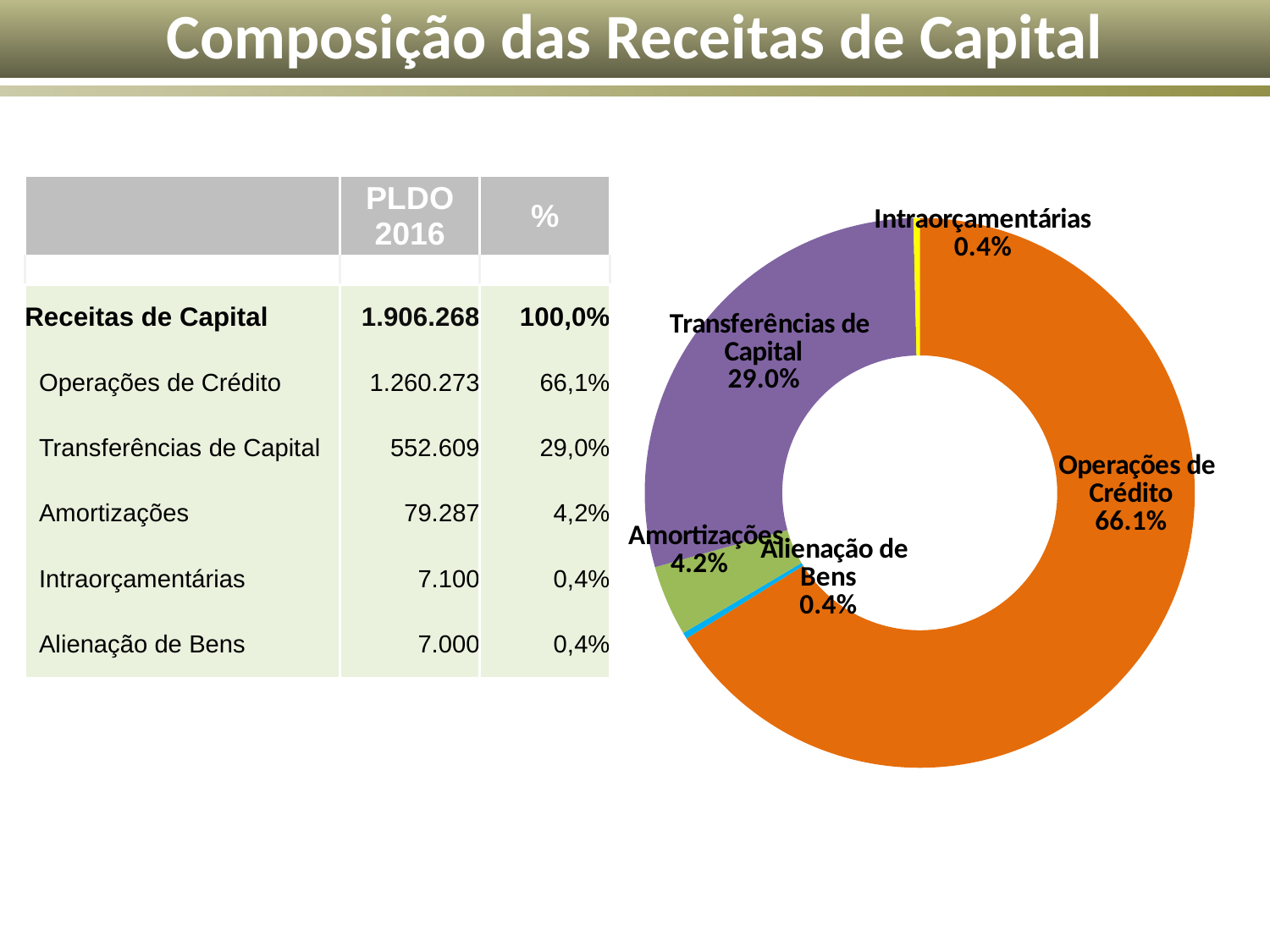
What colour is the Operações de Crédito slice in the donut chart? Orange What percentage is shown for Intraorçamentárias in the donut chart? 0.4% What is the difference in percentage points between Amortizações and Alienação de Bens in the donut chart? 3.8 How many slices does the donut chart have? 5 What share of the donut chart does Operações de Crédito represent? 66.1% What percentage is shown for Amortizações in the donut chart? 4.2% Which category has the largest slice in the donut chart? Operações de Crédito What share of the donut chart does Transferências de Capital represent? 29.0% What is the difference in percentage points between Operações de Crédito and Transferências de Capital in the donut chart? 37.1 In the donut chart, which is larger: Transferências de Capital or Amortizações? Transferências de Capital What colour is the Transferências de Capital slice in the donut chart? Purple What kind of chart is shown on the slide? Donut (pie) chart